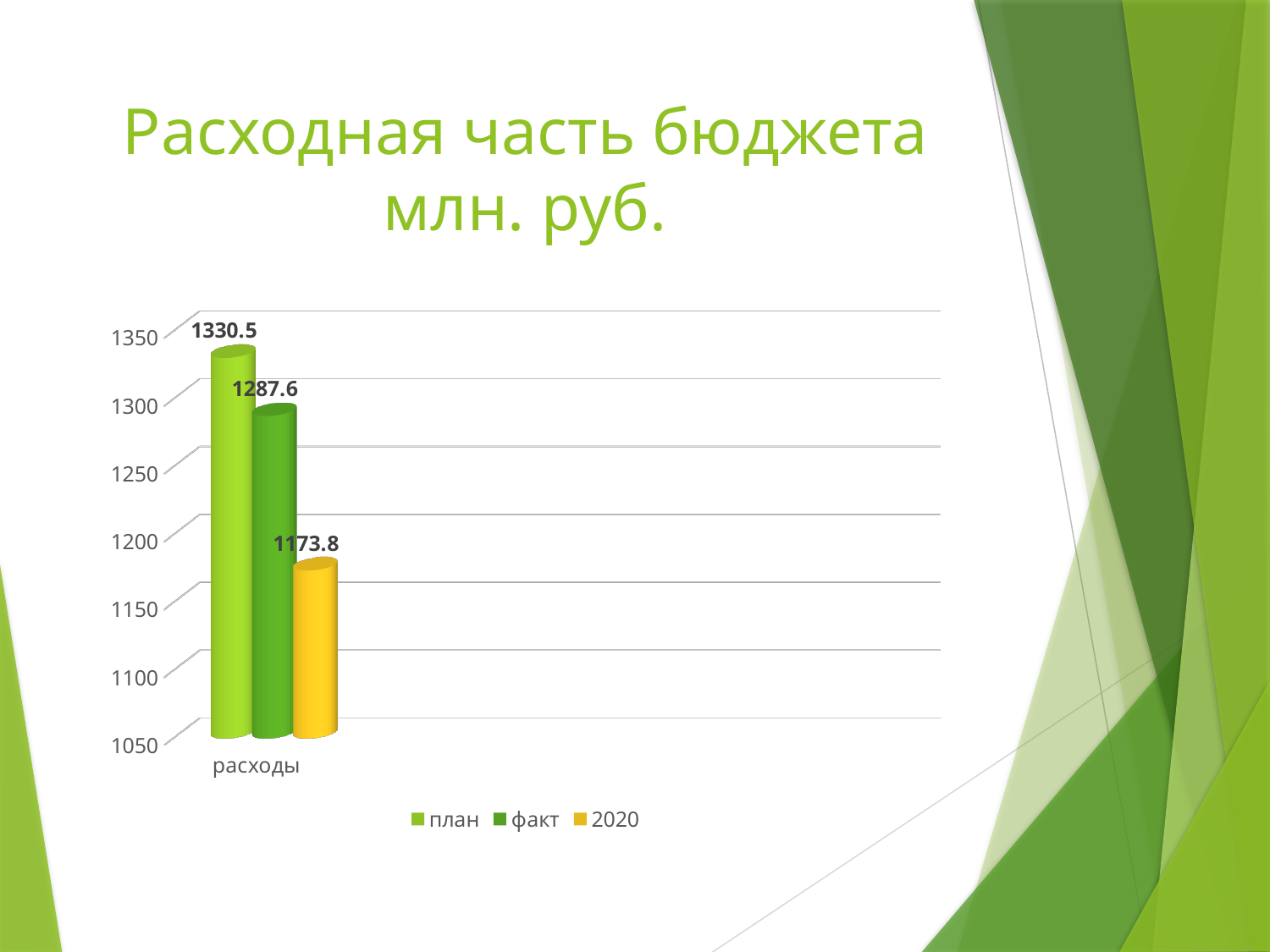
Which is larger for расходы, the факт value or the 2020 value? факт Which series has the lowest value for расходы? 2020 Is the value for 2020 greater or less than 1200? less Which series has the highest value for расходы? план What is the value of the факт series for расходы? 1287.6 What is the difference between the план and факт values for расходы? 42.9 How many series does the legend list? 3 What is the value of the 2020 series for расходы? 1173.8 What is the title of the chart on the slide? Расходная часть бюджета млн. руб. What is the difference between the факт and 2020 values for расходы? 113.8 What kind of chart is shown on the slide? bar chart What is the value of the план series for расходы? 1330.5